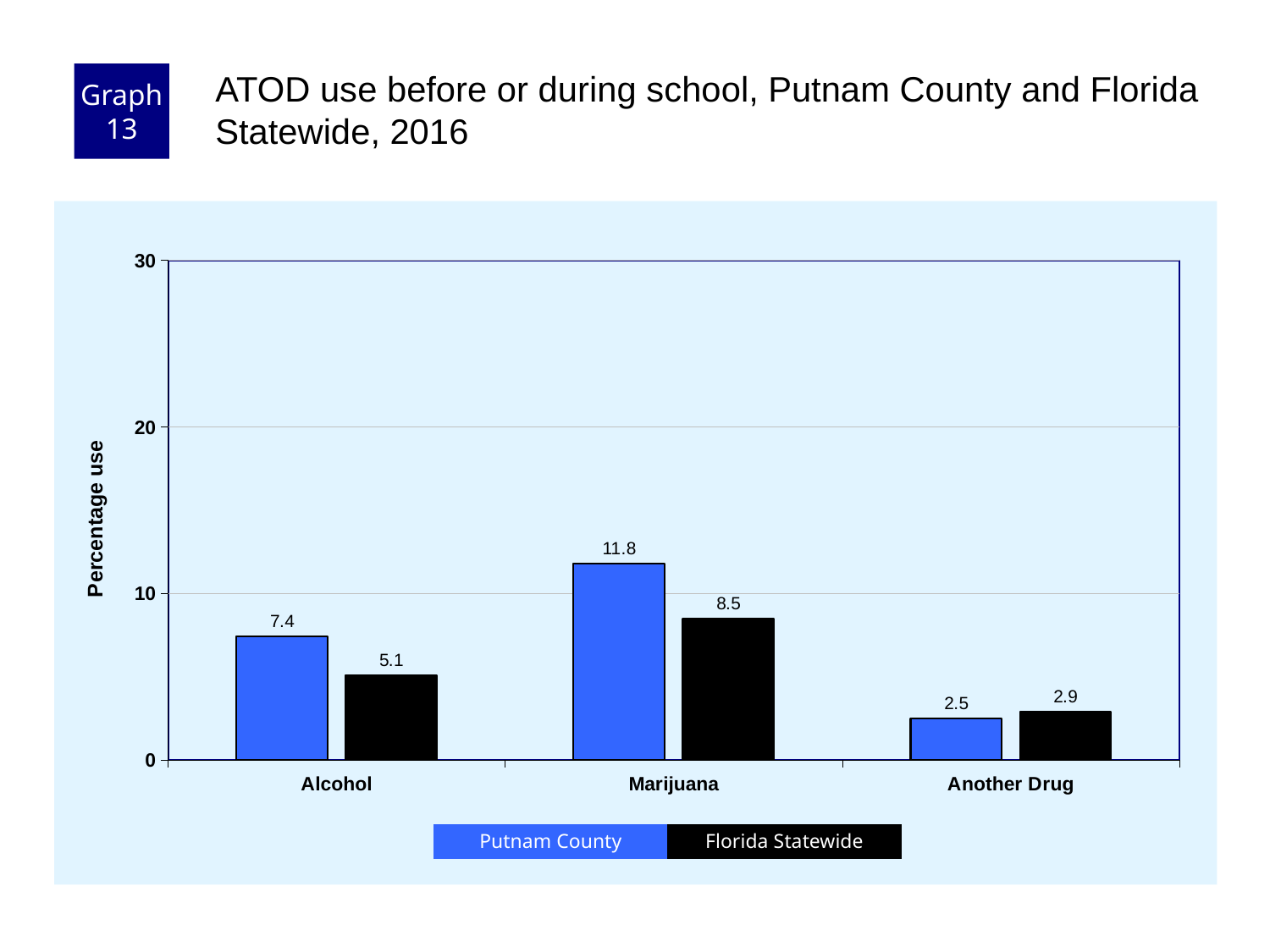
Which category has the lowest Florida Statewide value? Another Drug What is the difference between the Putnam County and Florida Statewide values for Alcohol? 2.3 How many categories are shown on the x axis? 3 What is the Putnam County value for Marijuana? 11.8 For Another Drug, which is larger: Putnam County or Florida Statewide? Florida Statewide What kind of chart is shown on the slide? Bar chart How many series does the legend list? 2 What is the difference between the Putnam County and Florida Statewide values for Marijuana? 3.3 What is the Putnam County value for Another Drug? 2.5 What is the Florida Statewide value for Alcohol? 5.1 Which category has the highest Putnam County value? Marijuana Is the Putnam County value for Marijuana greater or less than 10? greater